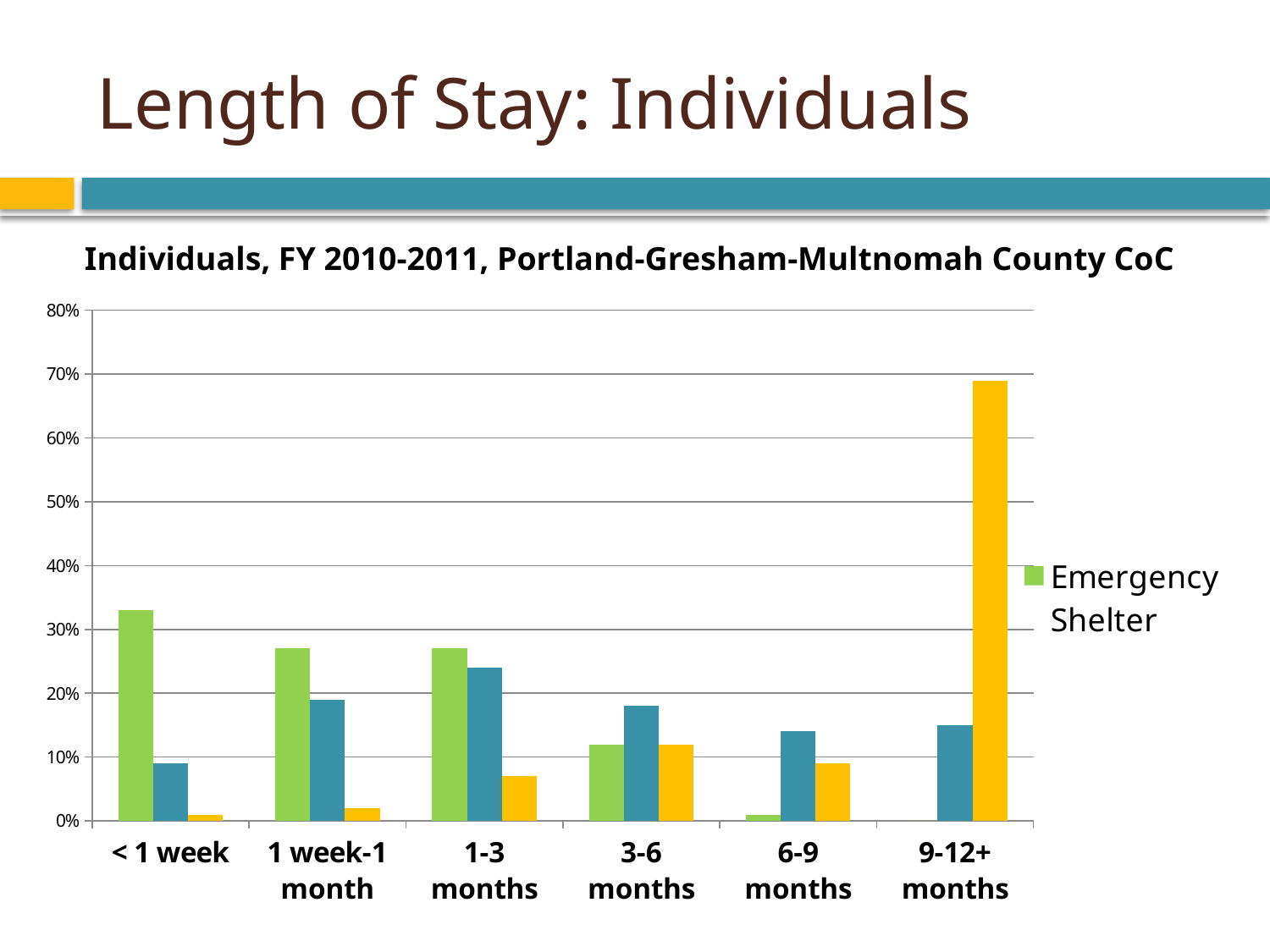
In which category does the tallest bar on the chart appear? 9-12+ months Is the Emergency Shelter value for 6-9 months greater or less than 10%? less What kind of chart is shown on the slide? Bar chart Do the Emergency Shelter values generally rise or fall from < 1 week to 9-12+ months? fall Which is larger, the Emergency Shelter value for < 1 week or for 3-6 months? < 1 week Is the Emergency Shelter value for 3-6 months greater or less than 20%? less How many length-of-stay categories are shown on the x axis? 6 How many series does the legend list? 1 What is the title of the chart? Individuals, FY 2010-2011, Portland-Gresham-Multnomah County CoC Which category has the highest Emergency Shelter value? < 1 week Is the Emergency Shelter value for < 1 week greater or less than 30%? greater What colour represents Emergency Shelter in the legend? Green